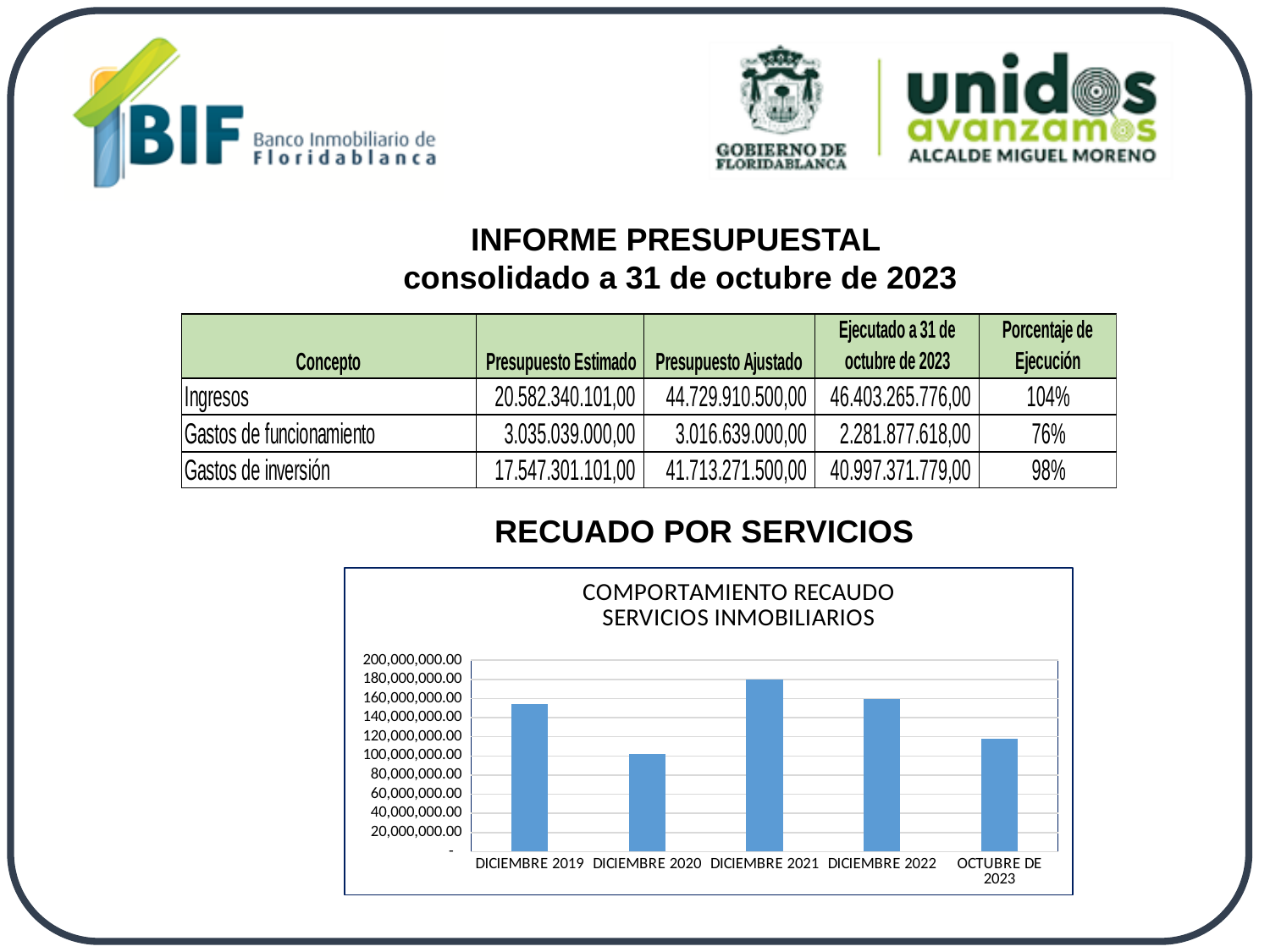
Which period has the highest bar in the chart? DICIEMBRE 2021 What kind of chart is shown under the heading RECUADO POR SERVICIOS? Bar chart Is the value for OCTUBRE DE 2023 greater or less than 140,000,000.00? less What is the highest value shown on the vertical axis of the chart? 200,000,000.00 Which is larger in the chart, the value for DICIEMBRE 2019 or DICIEMBRE 2020? DICIEMBRE 2019 Which period has the lowest bar in the chart? DICIEMBRE 2020 Is the value for DICIEMBRE 2019 greater or less than 120,000,000.00? greater What is the title of the chart on the slide? COMPORTAMIENTO RECAUDO SERVICIOS INMOBILIARIOS Is the value for DICIEMBRE 2020 greater or less than 120,000,000.00? less Which is larger in the chart, the value for DICIEMBRE 2021 or OCTUBRE DE 2023? DICIEMBRE 2021 How many categories (periods) are plotted in the chart? 5